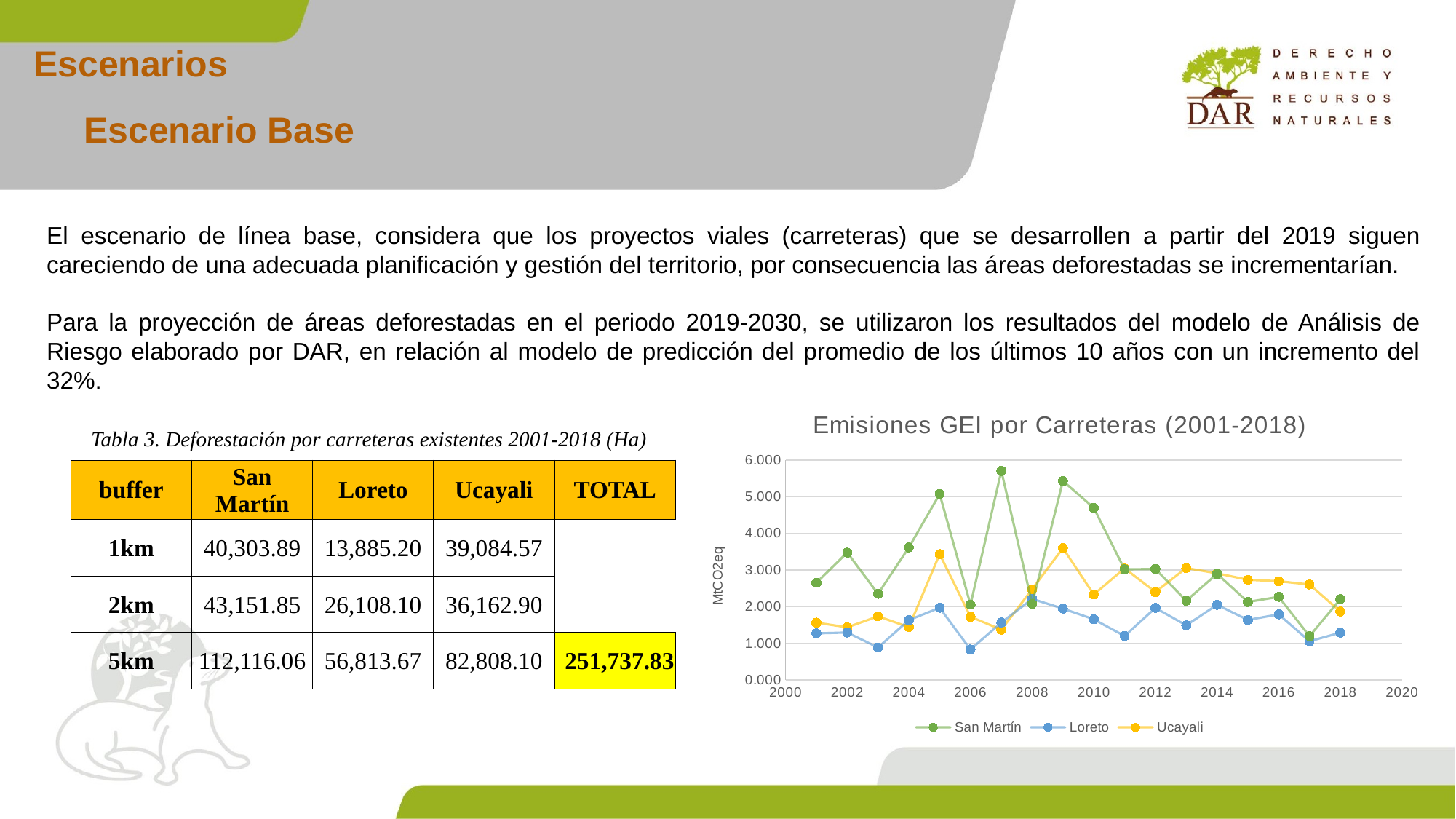
In the 'Emisiones GEI por Carreteras (2001-2018)' chart, does the San Martín series rise or fall from 2009 to 2011? fall In the 'Emisiones GEI por Carreteras (2001-2018)' chart, is the value for Ucayali in 2009 greater or less than 3.000? greater In the 'Emisiones GEI por Carreteras (2001-2018)' chart, is the value for San Martín in 2009 greater or less than 5.000? greater How many series does the legend of the 'Emisiones GEI por Carreteras (2001-2018)' chart list? 3 In the 'Emisiones GEI por Carreteras (2001-2018)' chart, which series has the lowest value in 2012? Loreto What is the label on the vertical axis of the 'Emisiones GEI por Carreteras (2001-2018)' chart? MtCO2eq In the 'Emisiones GEI por Carreteras (2001-2018)' chart, which series has the highest value in 2007? San Martín In the 'Emisiones GEI por Carreteras (2001-2018)' chart, is the value for Loreto in 2006 greater or less than 1.000? less What kind of chart is 'Emisiones GEI por Carreteras (2001-2018)'? line chart Which series are listed in the legend of the 'Emisiones GEI por Carreteras (2001-2018)' chart? San Martín, Loreto, Ucayali In the 'Emisiones GEI por Carreteras (2001-2018)' chart, which is larger in 2013, San Martín or Ucayali? Ucayali